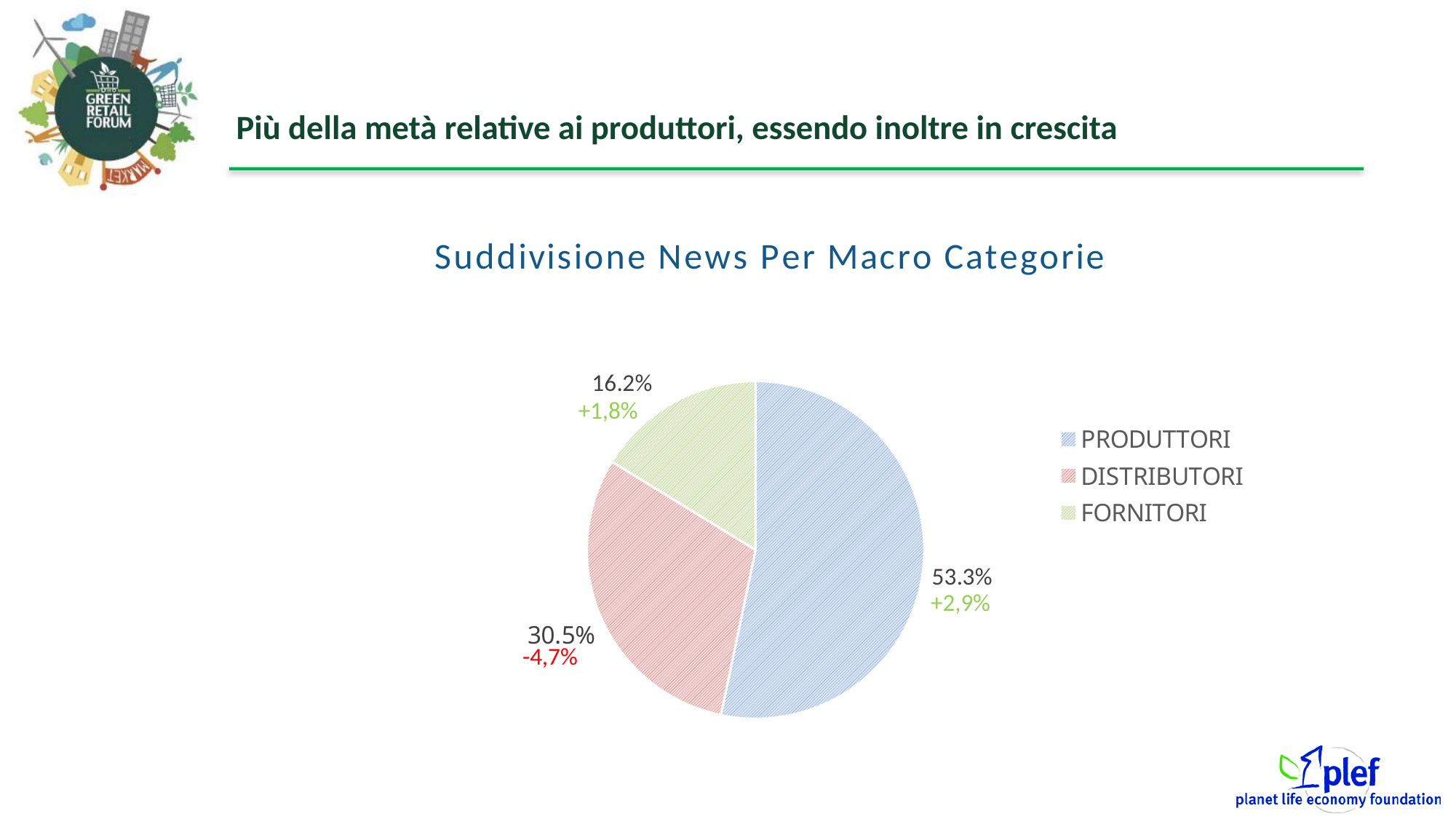
What kind of chart is shown on the slide? Pie chart What is the title of the chart? Suddivisione News Per Macro Categorie What share of the pie does FORNITORI hold? 16.2% What share of the pie does DISTRIBUTORI hold? 30.5% What is the difference in percentage points between the PRODUTTORI and DISTRIBUTORI slices? 22.8 How many categories does the pie chart show? 3 What change is shown next to the DISTRIBUTORI slice? -4,7% What change is shown next to the FORNITORI slice? +1,8% Which slice is larger, DISTRIBUTORI or FORNITORI? DISTRIBUTORI What share of the pie does PRODUTTORI hold? 53.3% Which category has the largest slice of the pie? PRODUTTORI Which category has the smallest slice of the pie? FORNITORI